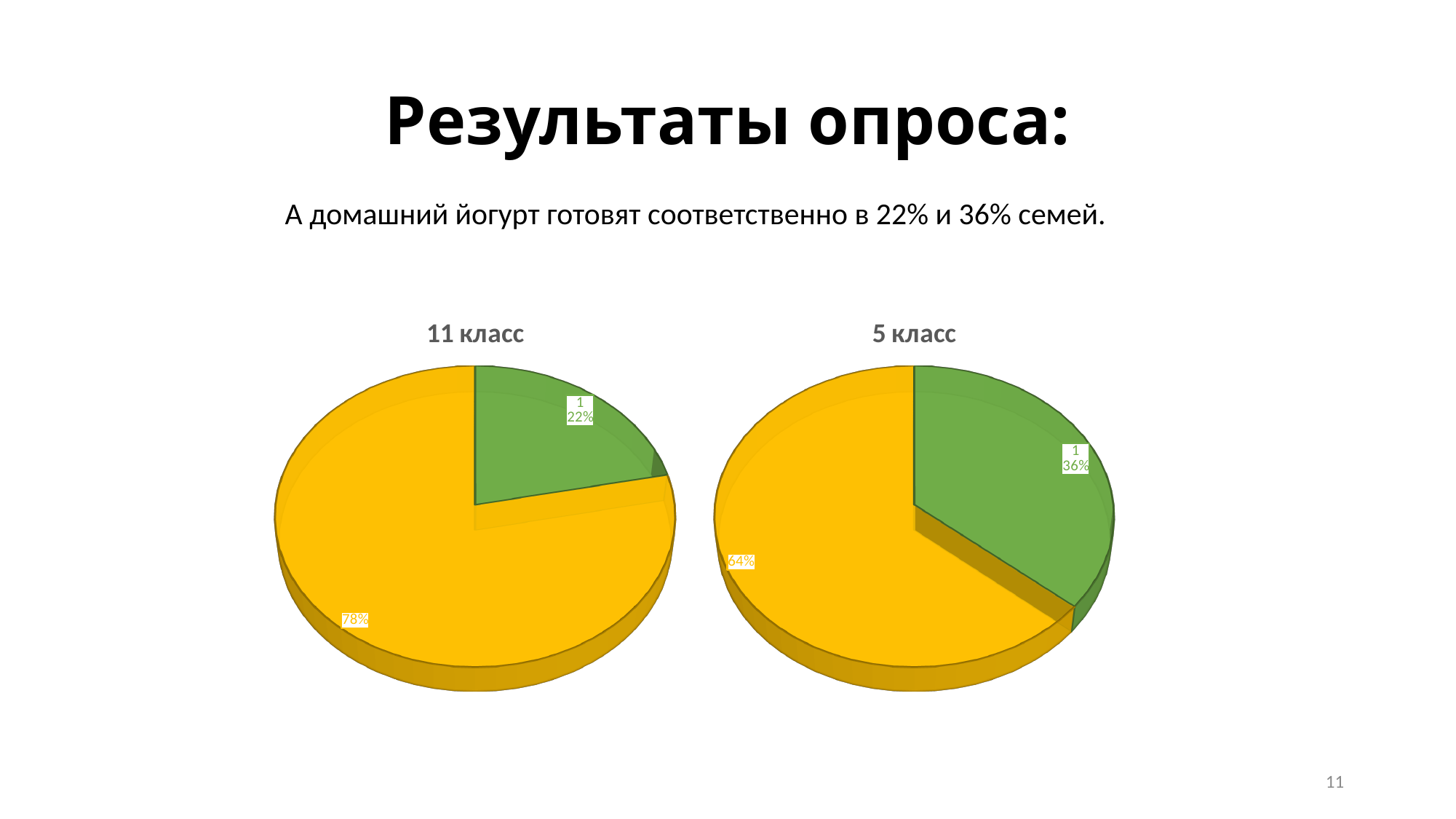
In the "11 класс" chart, what percentage is shown on the yellow slice? 78% How many slices does the "11 класс" pie chart have? 2 In the "11 класс" chart, what share of the pie does the green slice labelled "1" take? 22% What kind of chart is the "11 класс" chart? pie chart In the "11 класс" chart, which slice is the smallest? the green slice labelled 1 (22%) What kind of chart is the "5 класс" chart? pie chart In the "5 класс" chart, what percentage is shown on the yellow slice? 64% What is the difference between the green slice share in the "5 класс" chart and the green slice share in the "11 класс" chart? 14% In the "5 класс" chart, what share of the pie does the green slice labelled "1" take? 36% How many slices does the "5 класс" pie chart have? 2 Which chart has the larger green slice, "11 класс" or "5 класс"? 5 класс In the "5 класс" chart, which slice is the largest? the yellow slice (64%)